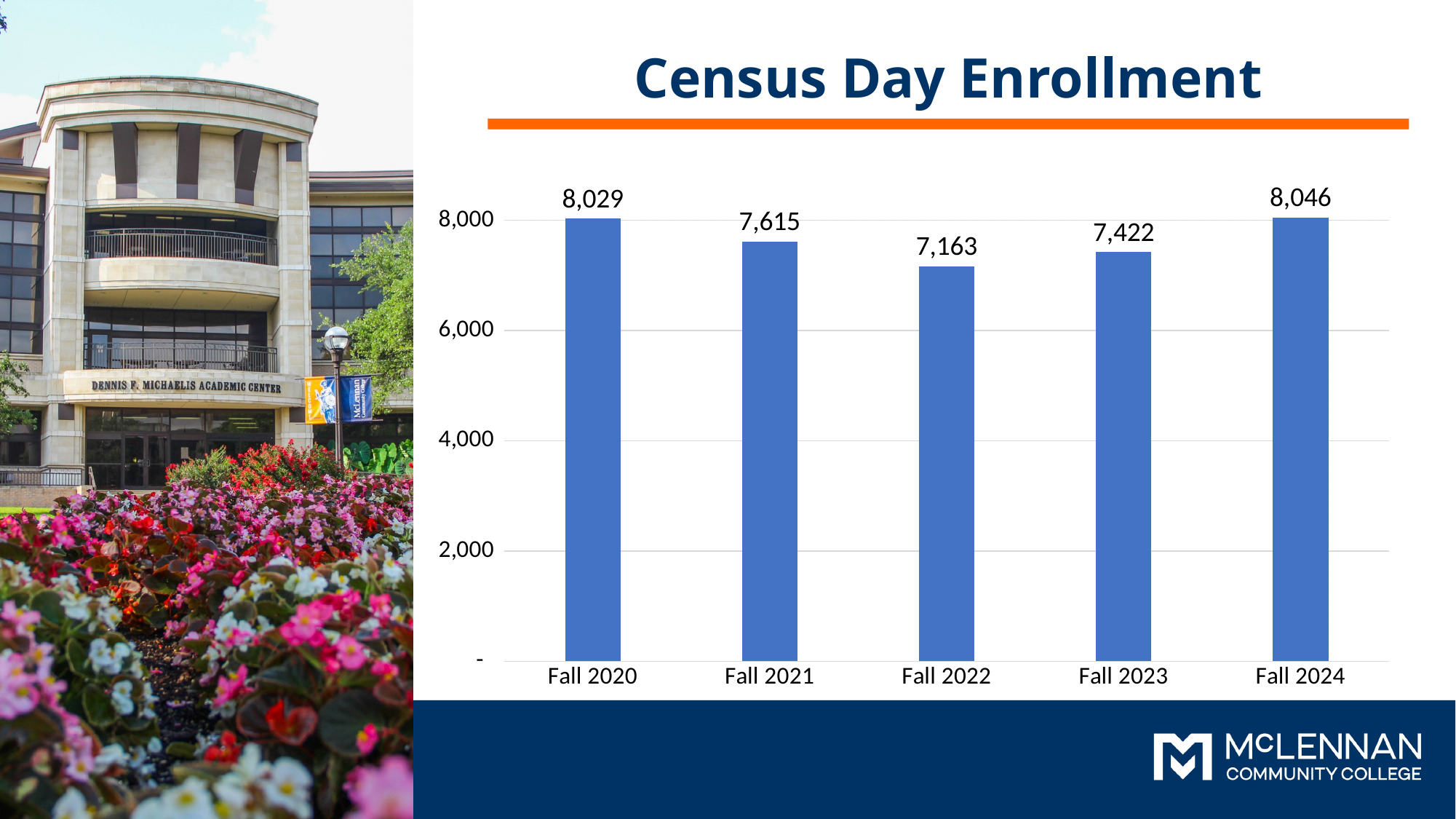
Which has the larger enrollment, Fall 2021 or Fall 2023? Fall 2021 What is the Census Day Enrollment for Fall 2022? 7,163 What kind of chart is shown on the slide? Bar chart What is the title of the chart? Census Day Enrollment How many terms are shown on the chart? 5 What is the difference in enrollment between Fall 2020 and Fall 2021? 414 What is the Census Day Enrollment for Fall 2020? 8,029 What is the Census Day Enrollment for Fall 2024? 8,046 Which term has the highest Census Day Enrollment? Fall 2024 Is the enrollment for Fall 2022 greater or less than 8,000? less Which term has the lowest Census Day Enrollment? Fall 2022 What is the difference in enrollment between Fall 2023 and Fall 2022? 259